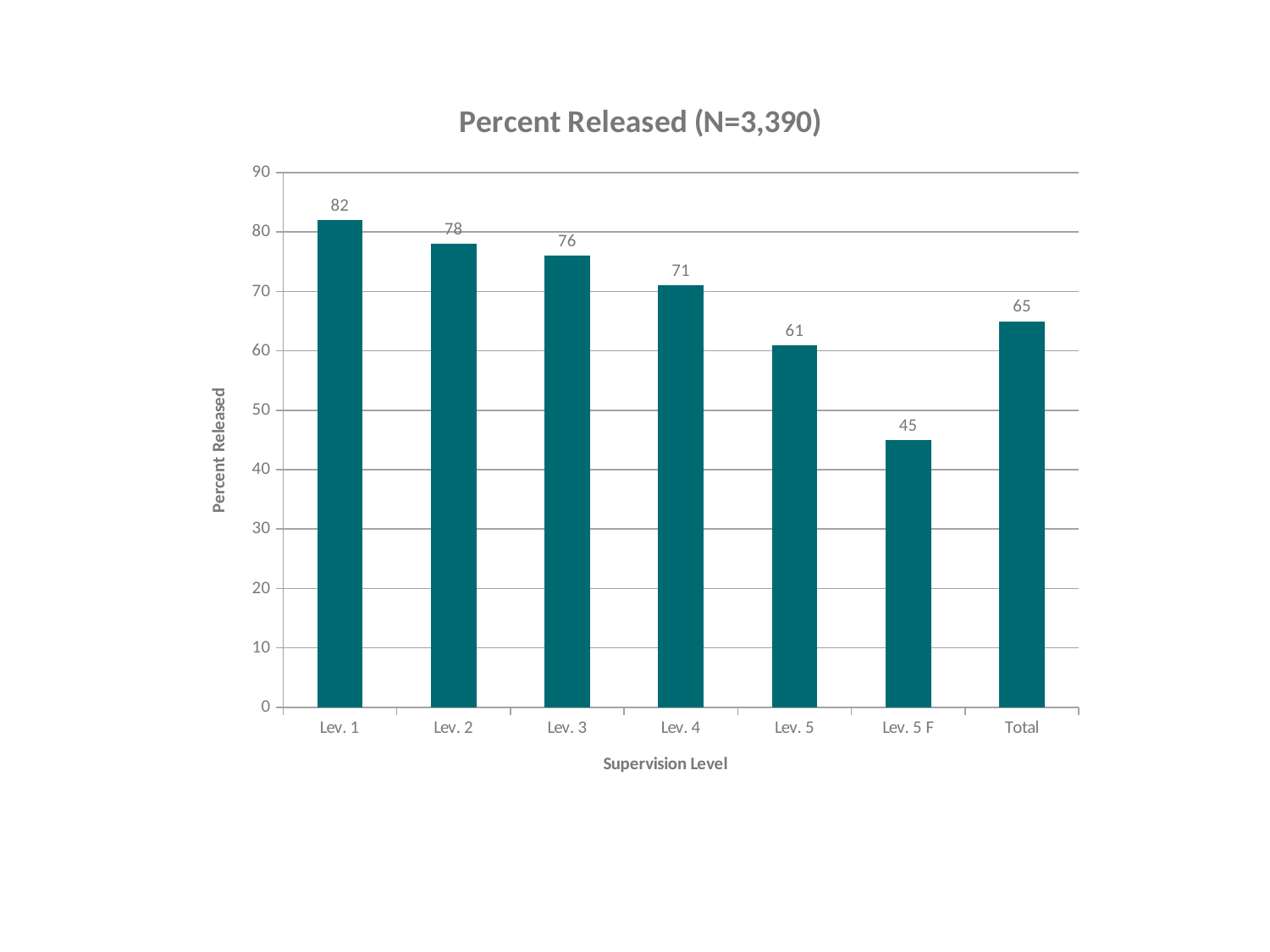
Is the value for Lev. 5 greater or less than 50? greater What is the percent released for the Total category? 65 What is the percent released for Lev. 5 F? 45 Which has a higher percent released, Lev. 3 or Lev. 5? Lev. 3 What is the title of the chart? Percent Released (N=3,390) What is the percent released for Lev. 1? 82 Which supervision level has the lowest percent released? Lev. 5 F What is the difference in percent released between Lev. 1 and Lev. 5 F? 37 Which supervision level has the highest percent released? Lev. 1 What kind of chart is shown on the slide? Bar chart What is the difference in percent released between Lev. 2 and Lev. 4? 7 How many categories are shown on the x axis? 7